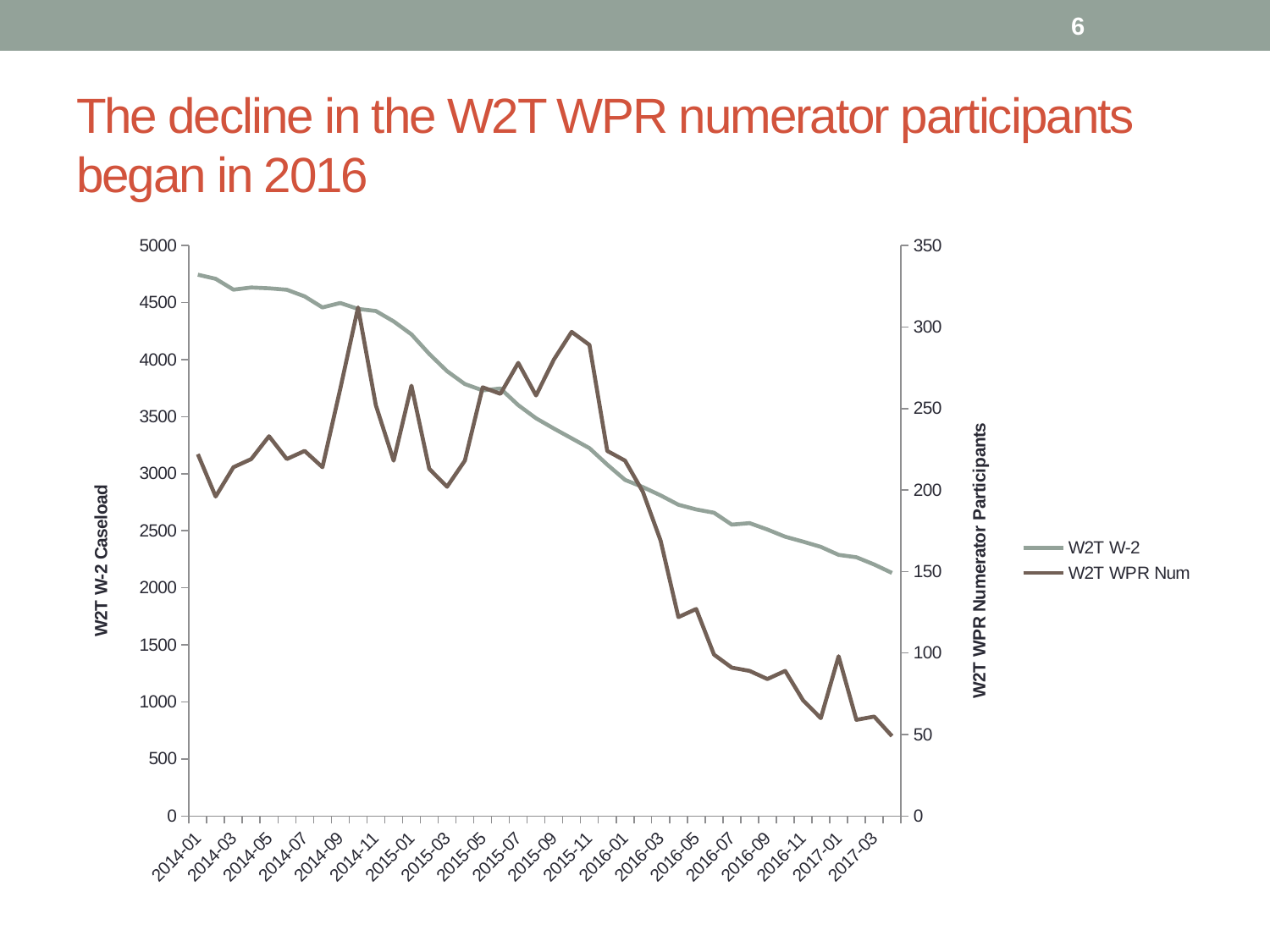
Is the W2T W-2 value at 2017-03 greater or less than 2500? less How many series does the legend list? 2 Is the W2T W-2 value at 2014-01 greater or less than 4500? greater At which x-axis date is the W2T W-2 series at its highest? 2014-01 Does the W2T W-2 series rise or fall from 2014-01 to 2017-03? fall Overall, does the W2T WPR Num series rise or fall between 2015-11 and 2017-03? fall Is the W2T W-2 value at 2015-01 greater or less than 4000? greater What is the title of the left vertical axis? W2T W-2 Caseload What are the two series named in the legend? W2T W-2 and W2T WPR Num What kind of chart is shown on the slide? line chart